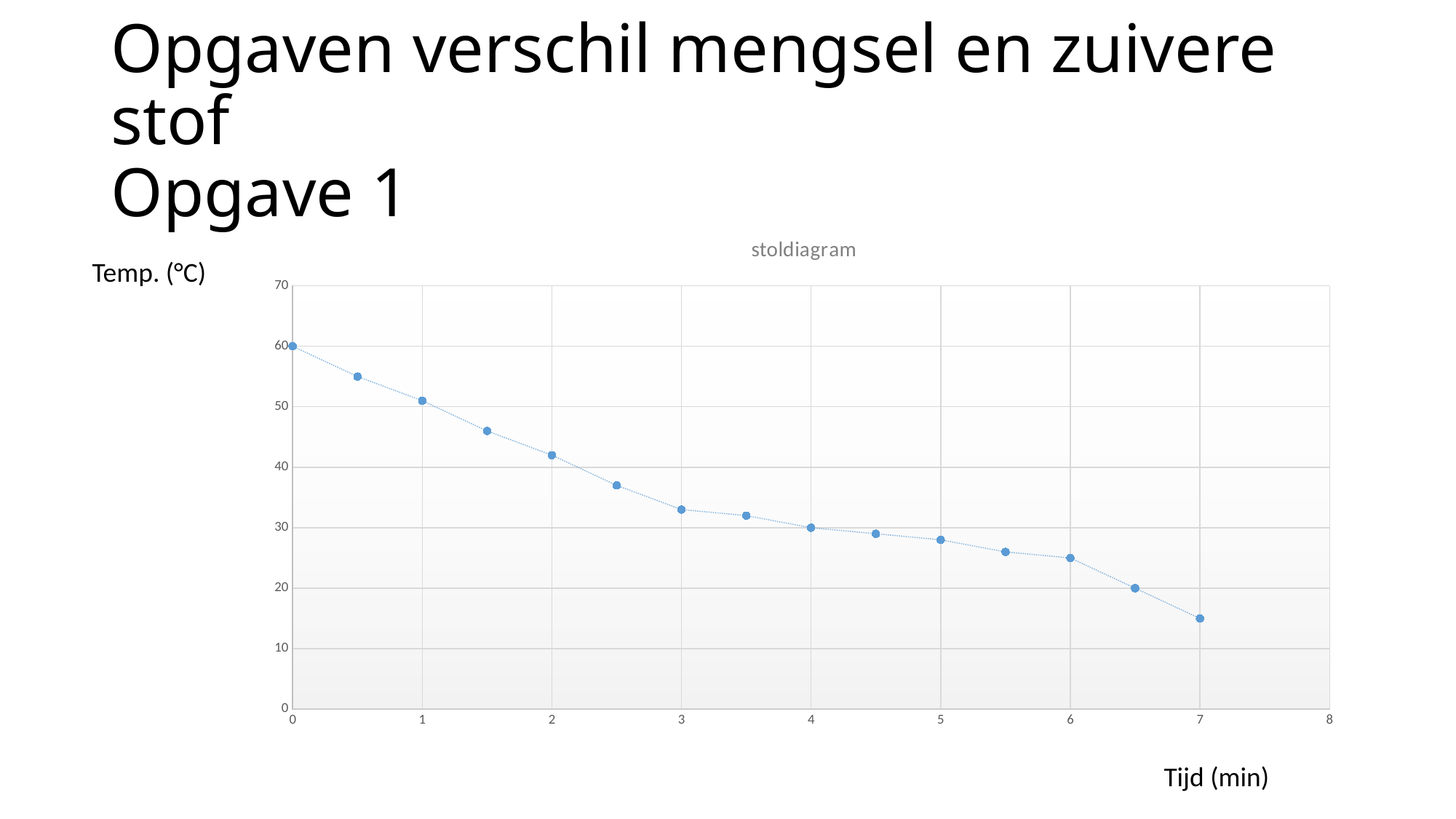
Is the temperature at 2 minutes greater or less than 40? greater What is the temperature at 4 minutes? 30 What is the temperature at 0 minutes? 60 What kind of chart is shown on the slide? line chart What is the temperature at 6.5 minutes? 20 Is the temperature at 7 minutes greater or less than 20? less At which time is the temperature highest? 0 min Does the temperature rise or fall as time increases? fall Which is higher, the temperature at 1 minute or at 5 minutes? 1 minute What is the title of the chart? stoldiagram At which time is the temperature lowest? 7 min